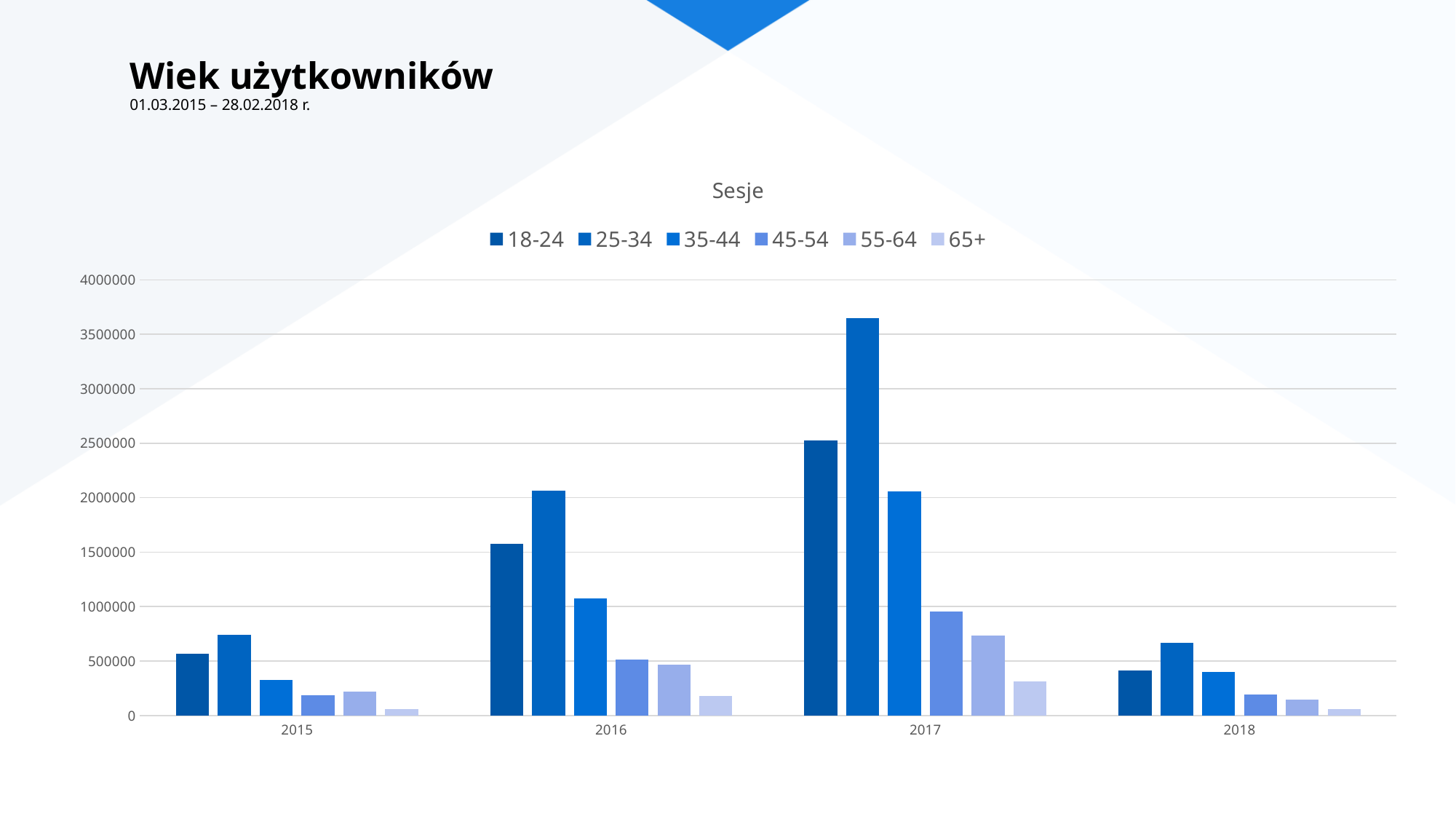
How many series does the legend list? 6 Which age group has the lowest bar in 2017? 65+ Do the values for 25-34 rise or fall from 2015 to 2017? rise Which is larger: the 18-24 bar in 2017 or the 25-34 bar in 2016? 18-24 in 2017 What kind of chart is shown on the slide? bar chart Is the value for 45-54 in 2017 greater or less than 1000000? less In which year is the 25-34 bar the highest? 2017 What is the title of the chart? Sesje Is the value for 25-34 in 2017 greater or less than 3500000? greater Is the value for 18-24 in 2016 greater or less than 1500000? greater How many years are shown on the x axis? 4